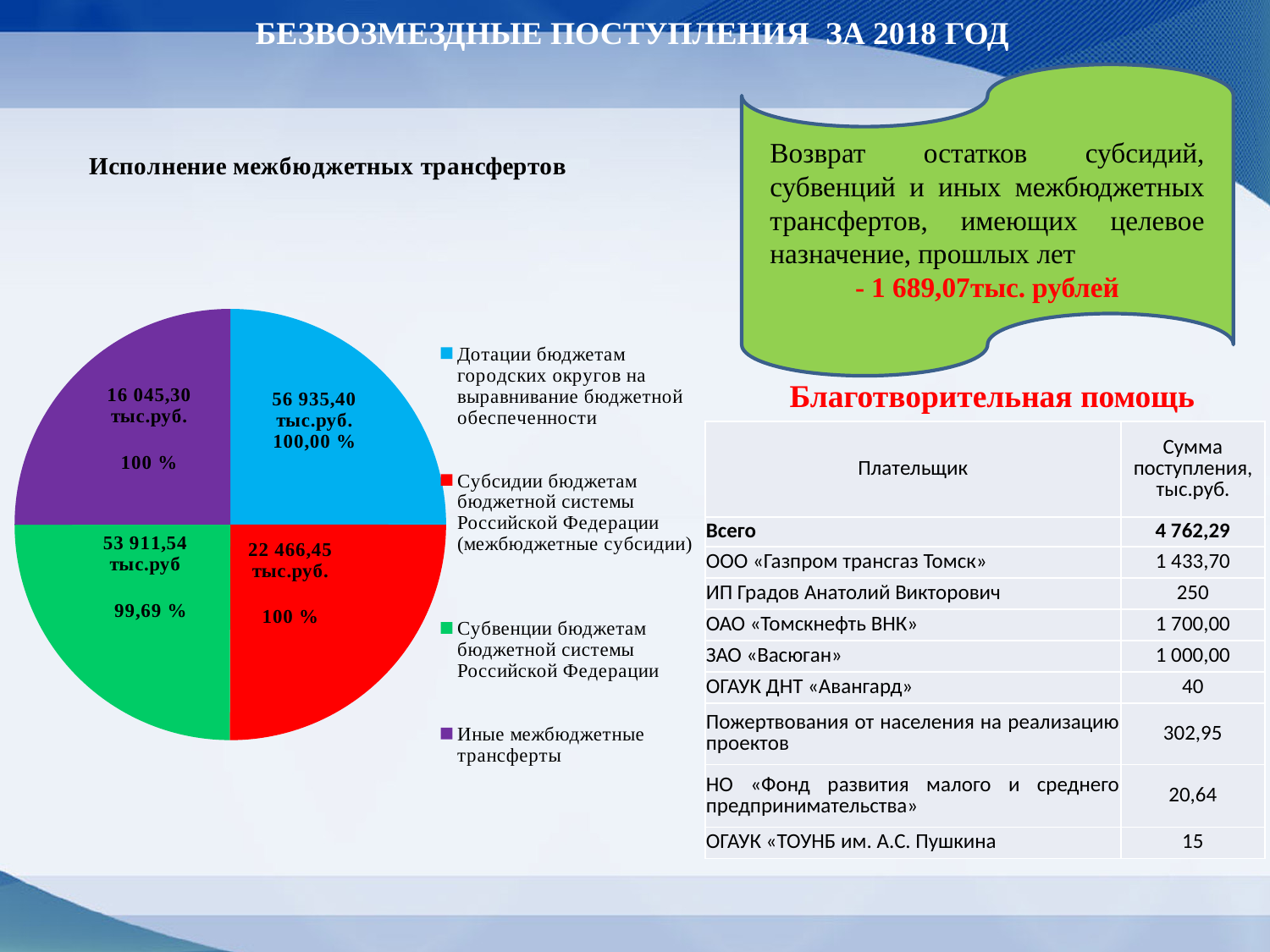
In the pie chart, what amount is shown for «Дотации бюджетам городских округов на выравнивание бюджетной обеспеченности»? 56 935,40 тыс.руб. In the pie chart, what amount is shown for «Иные межбюджетные трансферты»? 16 045,30 тыс.руб. In the pie chart, which is larger: the amount for «Субсидии» or the amount for «Иные межбюджетные трансферты»? Субсидии In the pie chart, what amount is shown for «Субсидии бюджетам бюджетной системы Российской Федерации (межбюджетные субсидии)»? 22 466,45 тыс.руб. What type of chart is shown under the heading «Исполнение межбюджетных трансфертов»? pie chart In the pie chart, what is the difference between the amounts for «Дотации» (56 935,40) and «Субвенции» (53 911,54)? 3 023,86 тыс.руб. How many slices does the pie chart «Исполнение межбюджетных трансфертов» have? 4 What colour represents «Субвенции бюджетам бюджетной системы Российской Федерации» in the pie chart? green In the pie chart, what execution percentage is shown for «Субвенции бюджетам бюджетной системы Российской Федерации»? 99,69 % How many entries does the legend of the pie chart list? 4 Which category in the pie chart has the smallest amount in тыс.руб.? Иные межбюджетные трансферты Which category in the pie chart has the largest amount in тыс.руб.? Дотации бюджетам городских округов на выравнивание бюджетной обеспеченности